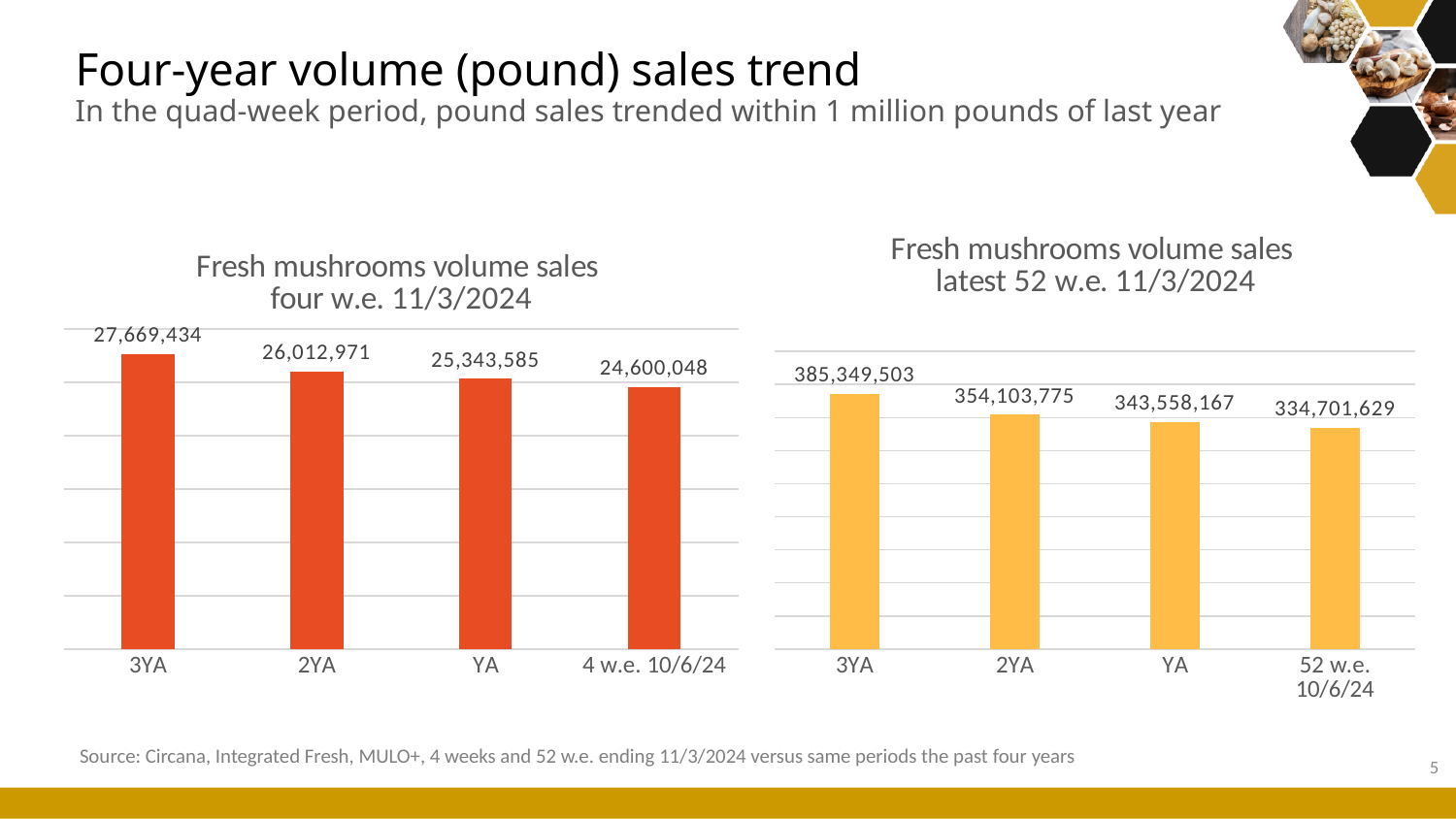
In the 'Fresh mushrooms volume sales four w.e. 11/3/2024' chart, what is the value for 4 w.e. 10/6/24? 24,600,048 In the 'Fresh mushrooms volume sales latest 52 w.e. 11/3/2024' chart, which category has the lowest value? 52 w.e. 10/6/24 What type of chart is the 'Fresh mushrooms volume sales latest 52 w.e. 11/3/2024' chart? Bar chart In the 'Fresh mushrooms volume sales latest 52 w.e. 11/3/2024' chart, what is the value for 2YA? 354,103,775 In the 'Fresh mushrooms volume sales four w.e. 11/3/2024' chart, do the values rise or fall from 3YA to 4 w.e. 10/6/24? Fall In the 'Fresh mushrooms volume sales four w.e. 11/3/2024' chart, what is the difference between the 3YA and 2YA values? 1,656,463 How many categories are shown in the 'Fresh mushrooms volume sales four w.e. 11/3/2024' chart? 4 In the 'Fresh mushrooms volume sales latest 52 w.e. 11/3/2024' chart, what is the difference between the YA and 52 w.e. 10/6/24 values? 8,856,538 In the 'Fresh mushrooms volume sales four w.e. 11/3/2024' chart, what is the value for 3YA? 27,669,434 In the 'Fresh mushrooms volume sales four w.e. 11/3/2024' chart, which category has the highest value? 3YA In the 'Fresh mushrooms volume sales latest 52 w.e. 11/3/2024' chart, what is the value for YA? 343,558,167 In the 'Fresh mushrooms volume sales latest 52 w.e. 11/3/2024' chart, which is larger, the value for 3YA or the value for 2YA? 3YA